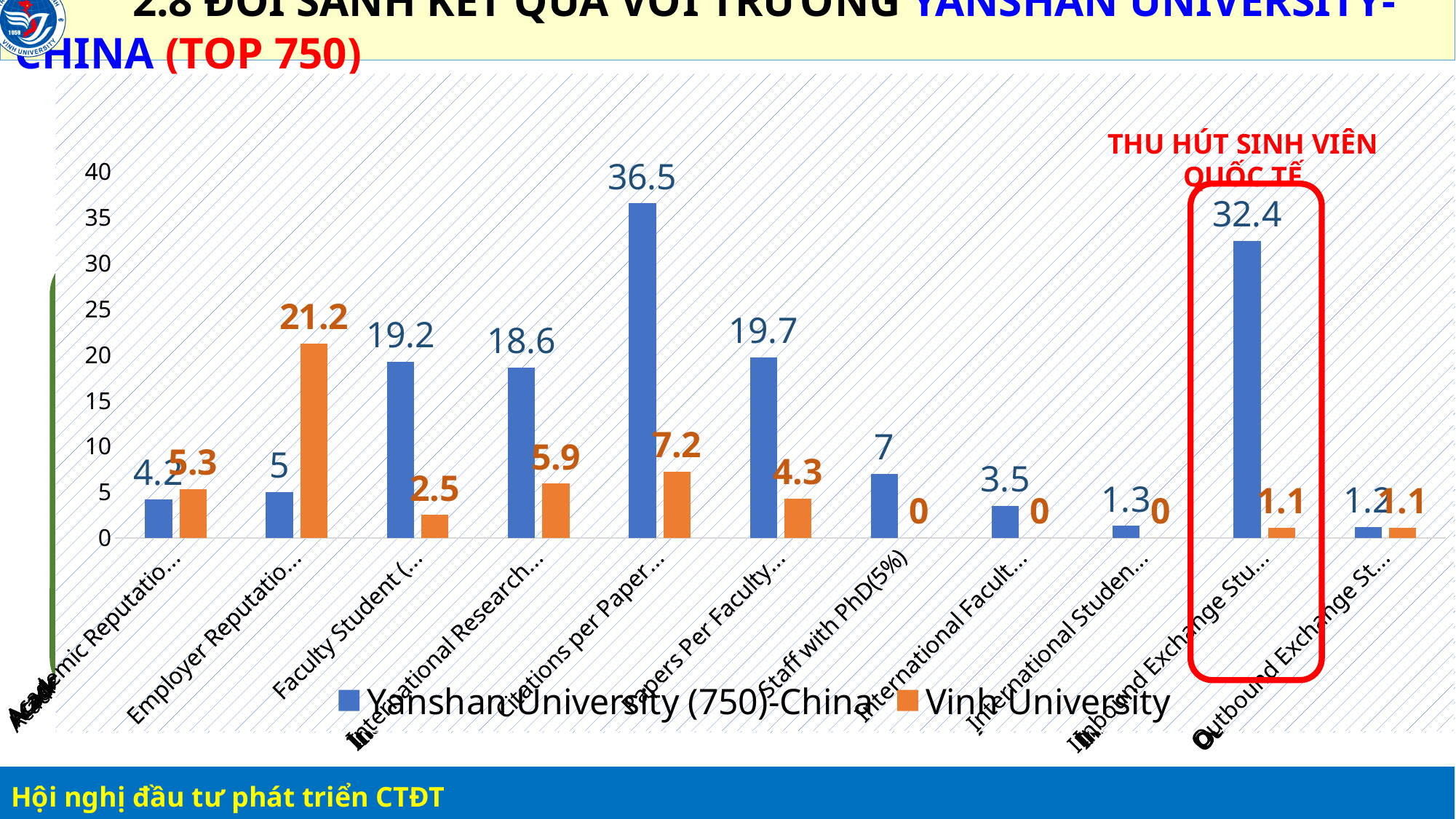
In the Academic Reputation category, which university has the larger value? Vinh University How many series does the legend list? 2 What is the difference between Yanshan University (750)-China and Vinh University in the Citations per Paper category? 29.3 What is the value for Vinh University in the Employer Reputation category? 21.2 How many categories are shown on the x axis? 11 What is the difference between Yanshan University (750)-China and Vinh University in the Inbound Exchange Students category? 31.3 In which category does Vinh University have its highest value? Employer Reputation What is the value for Yanshan University (750)-China in the Citations per Paper category? 36.5 In which category does Yanshan University (750)-China have its highest value? Citations per Paper What kind of chart is shown on the slide? bar chart Is the value for Yanshan University (750)-China in the Inbound Exchange Students category greater or less than 30? greater What is the value for Vinh University in the Staff with PhD(5%) category? 0